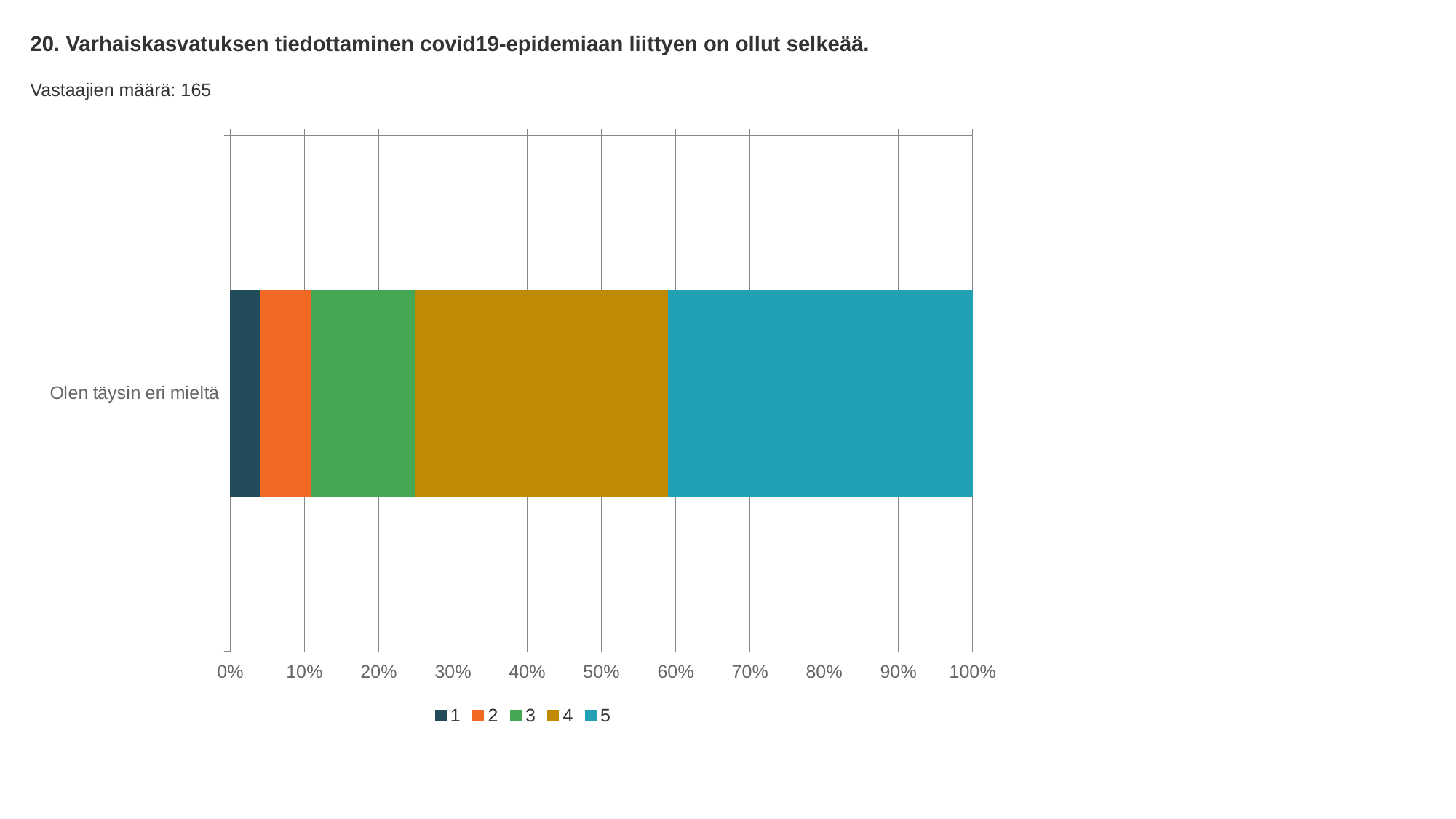
What is the label of the single category on the vertical axis? Olen täysin eri mieltä How many categories are plotted on the vertical axis? 1 Which segment is larger, series 5 or series 1? 5 What are the legend entries of the chart? 1, 2, 3, 4, 5 Is the share of series 1 greater or less than 10%? less Which series has the largest segment in the bar? 5 How many series does the legend list? 5 Is the combined share of series 1 to 4 greater or less than 50%? greater Which segment is larger, series 4 or series 3? 4 What is the maximum value shown on the horizontal axis? 100% Which series has the smallest segment in the bar? 1 What kind of chart is shown on the slide? Stacked bar chart